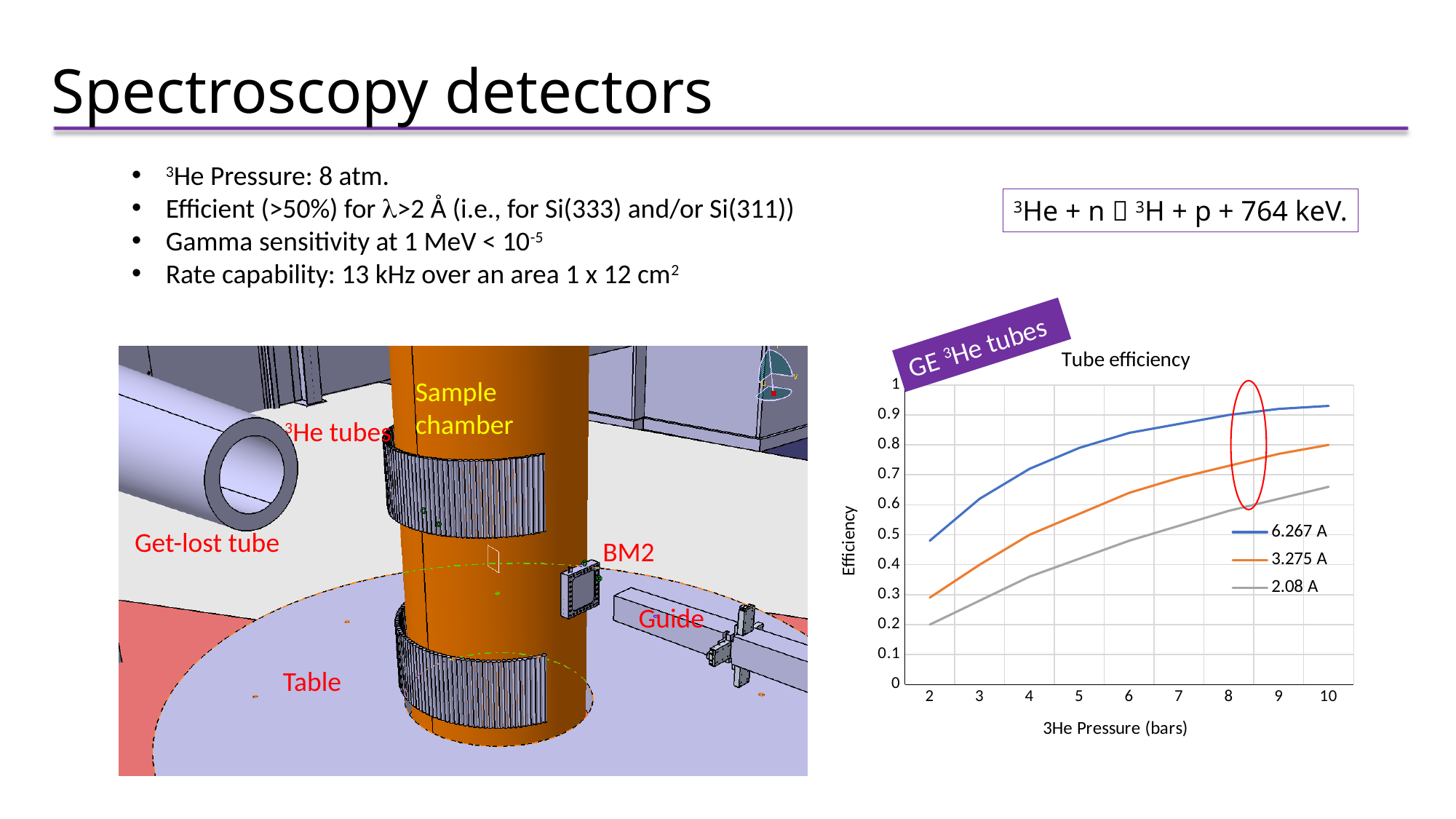
What kind of chart is the 'Tube efficiency' chart? line chart In the 'Tube efficiency' chart, which series has the highest efficiency across the pressure range? 6.267 A In the 'Tube efficiency' chart, is the efficiency of the 3.275 A series at 6 bars greater or less than 0.6? greater What is the x-axis label of the 'Tube efficiency' chart? 3He Pressure (bars) In the 'Tube efficiency' chart, at 6 bars, which series has the higher efficiency: 6.267 A or 2.08 A? 6.267 A What are the three series listed in the legend of the 'Tube efficiency' chart? 6.267 A, 3.275 A, 2.08 A How many series does the legend of the 'Tube efficiency' chart list? 3 In the 'Tube efficiency' chart, is the efficiency of the 6.267 A series at 10 bars greater or less than 0.9? greater In the 'Tube efficiency' chart, which series has the lowest efficiency across the pressure range? 2.08 A In the 'Tube efficiency' chart, is the efficiency of the 6.267 A series at 6 bars greater or less than 0.8? greater In the 'Tube efficiency' chart, does efficiency rise or fall as 3He pressure increases? rise